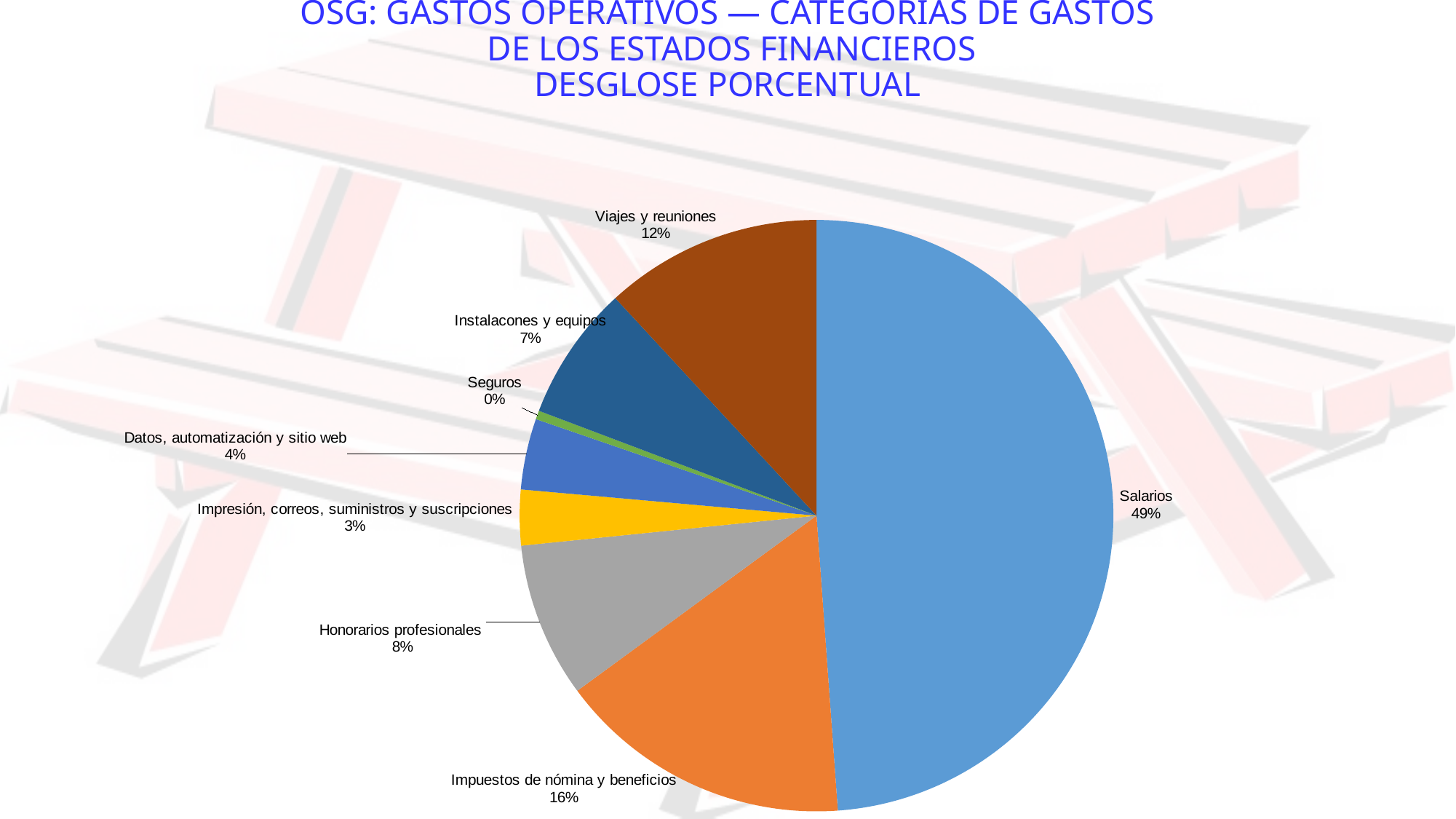
What percentage is shown for Impuestos de nómina y beneficios? 16% What percentage is shown for Viajes y reuniones? 12% Which is larger, Instalacones y equipos or Datos, automatización y sitio web? Instalacones y equipos How many categories are shown in the pie chart? 8 What percentage is shown for Seguros? 0% What type of chart is shown on the slide? Pie chart What is the combined share of Viajes y reuniones and Instalacones y equipos? 19% What percentage is shown for Honorarios profesionales? 8% Which category has the smallest share of the pie? Seguros Which category has the largest share of the pie? Salarios What is the difference in percentage points between Salarios and Impuestos de nómina y beneficios? 33 What share of the pie does Salarios represent? 49%